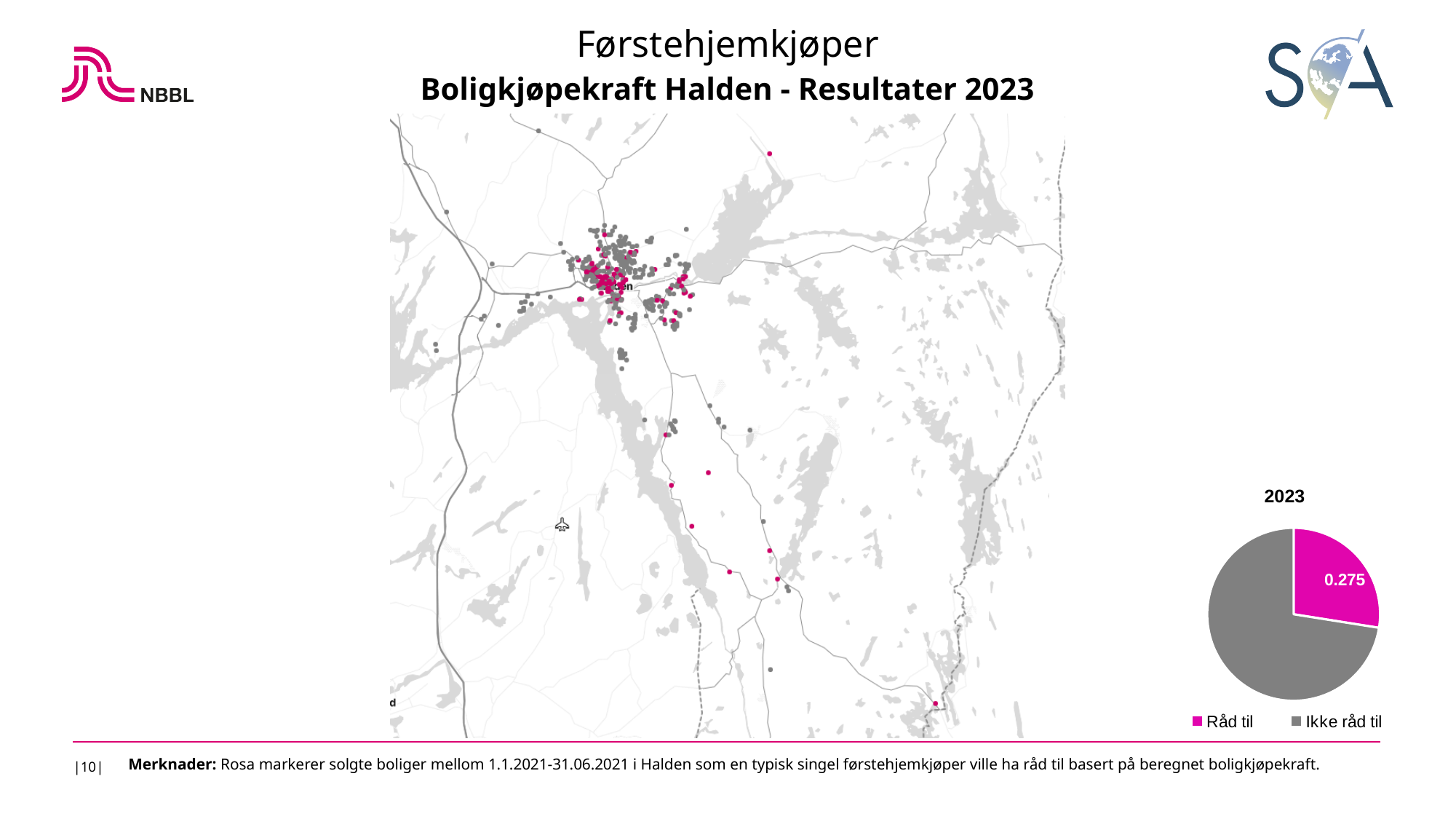
What is the title shown above the pie chart on the right of the slide? 2023 In the pie chart titled 2023, which slice is larger, Råd til or Ikke råd til? Ikke råd til How many slices does the pie chart titled 2023 have? 2 In the pie chart titled 2023, which category has the smallest slice? Råd til In the pie chart titled 2023, what share of the pie does the Råd til slice represent? 0.275 In the pie chart titled 2023, which category has the largest slice? Ikke råd til In the pie chart titled 2023, what colour is the Råd til slice? Pink What kind of chart is shown on the right side of the slide under the heading 2023? Pie chart How many entries does the legend of the pie chart titled 2023 list? 2 In the pie chart titled 2023, what value is printed on the Råd til slice? 0.275